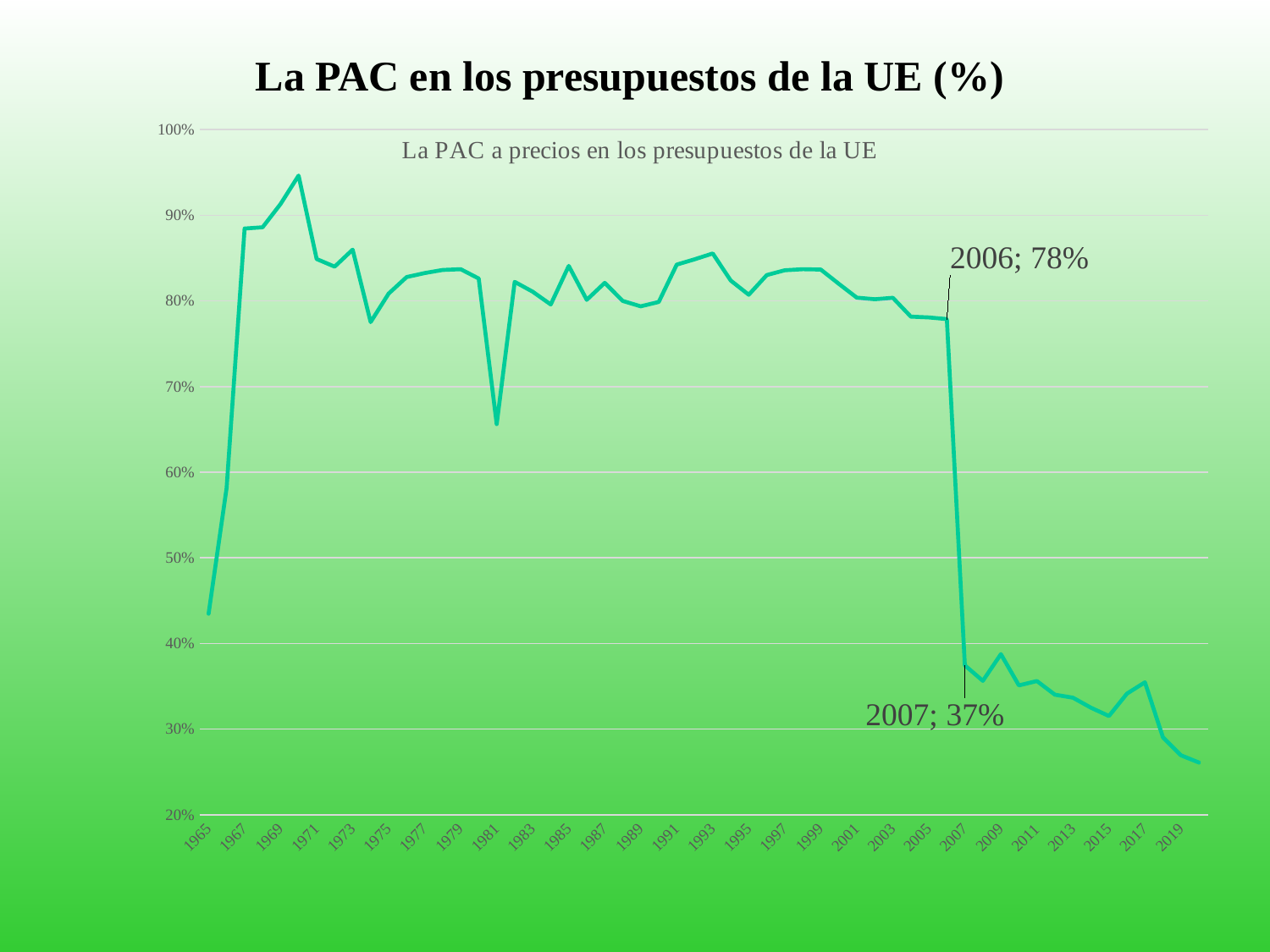
What value is labelled for 2006? 78% What value is labelled for 2007? 37% Is the value for 1981 greater or less than 70%? less Which year has the larger labelled value, 2006 or 2007? 2006 What kind of chart is shown on the slide? Line chart What is the lowest value shown on the vertical axis? 20% Is the value for 1965 greater or less than 50%? less What is the difference between the labelled values for 2006 and 2007? 41% Is the value for 1999 greater or less than 80%? greater Do the values generally rise or fall from 2007 to 2019? fall What is the title shown inside the chart area? La PAC a precios en los presupuestos de la UE